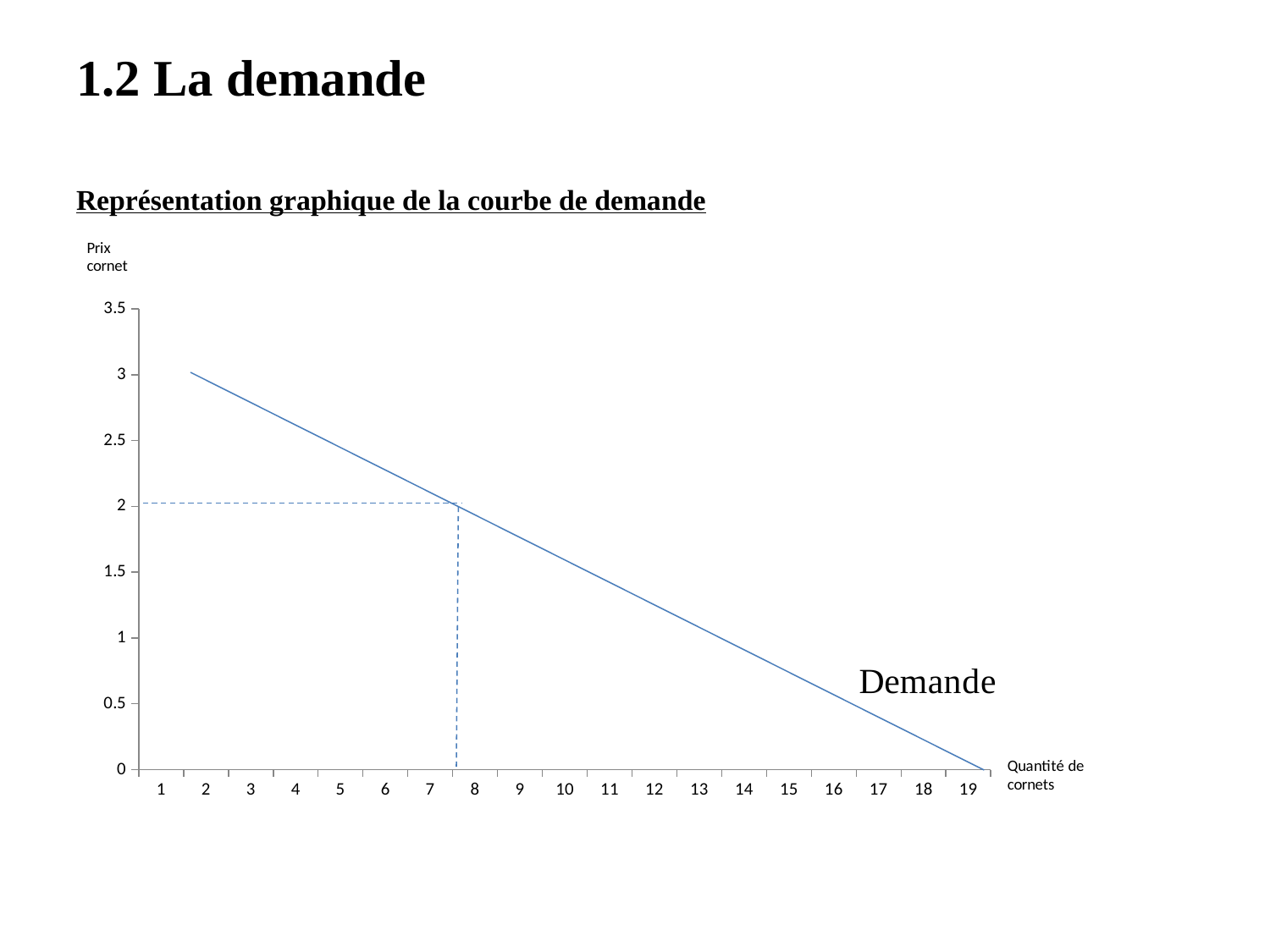
Is the price on the demand curve at a quantity of 3 cornets greater or less than 2.5? greater What kind of chart is shown on the slide? line chart Is the price on the demand curve at a quantity of 18 cornets greater or less than 0.5? less Is the price on the demand curve at a quantity of 6 cornets greater or less than 2.5? less What is the title of the chart? Représentation graphique de la courbe de demande Does the demand curve rise or fall as the quantity of cornets increases along the x axis? fall How many quantity values are labelled on the x axis of the chart? 19 What label is written next to the plotted line on the chart? Demande